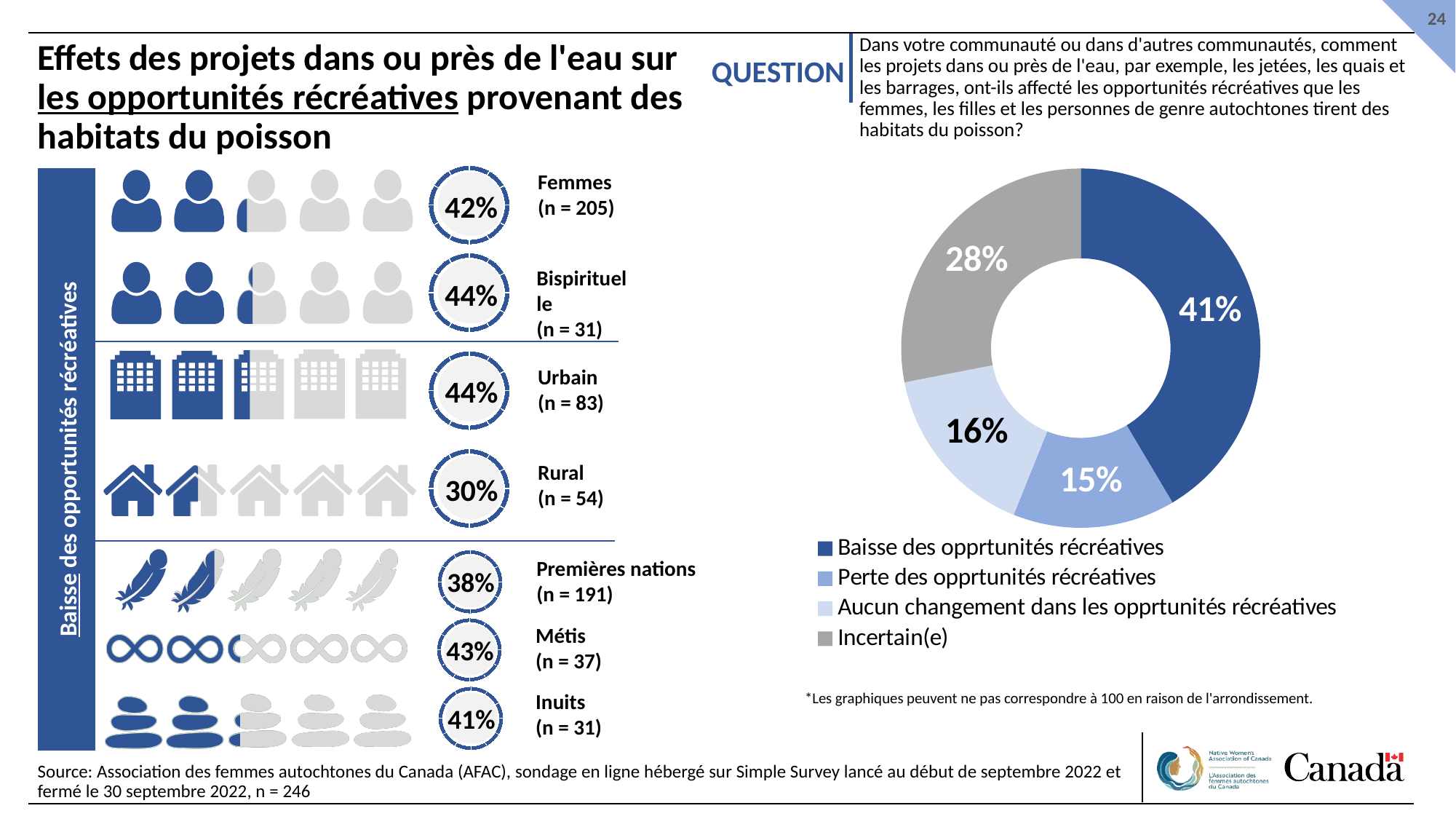
In the pictogram chart on the left, what percentage is shown for 'Rural (n = 54)'? 30% On the donut chart on the right, what share is labelled for 'Perte des opprtunités récréatives'? 15% On the donut chart on the right, what share is labelled for 'Baisse des opprtunités récréatives'? 41% On the donut chart on the right, what is the difference between the 'Baisse des opprtunités récréatives' slice and the 'Incertain(e)' slice? 13% On the donut chart on the right, which category has the smallest slice? Perte des opprtunités récréatives In the pictogram chart on the left, which is larger, the percentage for 'Urbain' or for 'Rural'? Urbain On the donut chart on the right, what share is labelled for 'Aucun changement dans les opprtunités récréatives'? 16% On the donut chart on the right, which category has the largest slice? Baisse des opprtunités récréatives What kind of chart is shown on the right side of the slide? Donut (pie) chart In the pictogram chart on the left, what percentage is shown for 'Premières nations (n = 191)'? 38% How many categories does the legend of the donut chart on the right list? 4